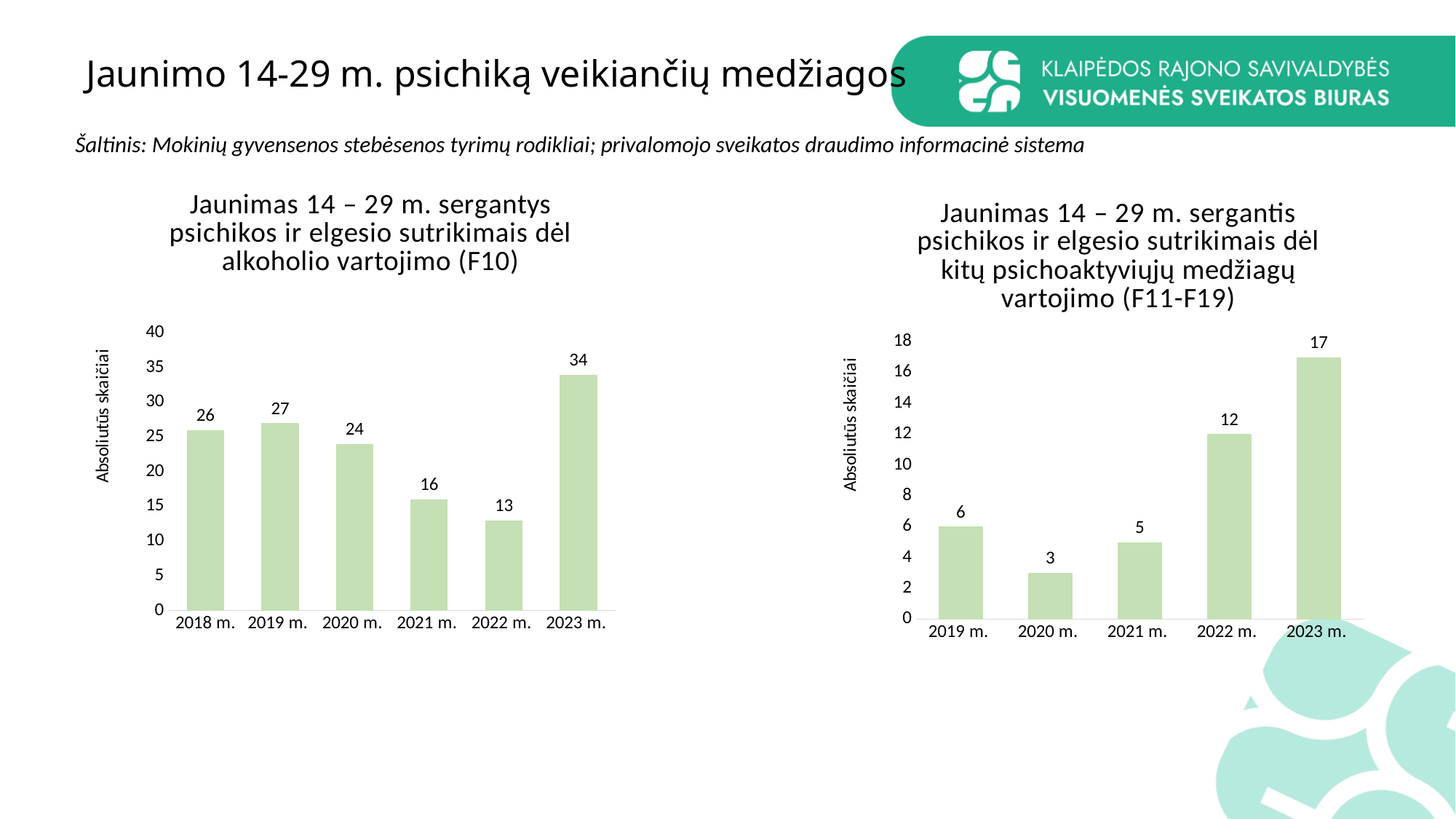
In the right chart (F11-F19), what is the difference between the values for 2023 m. and 2022 m.? 5 In the left chart (alkoholio vartojimo, F10), what is the value for 2023 m.? 34 In the right chart (F11-F19), which year has the highest value? 2023 m. In the left chart (alkoholio vartojimo, F10), how many years are shown on the x axis? 6 In the right chart (F11-F19), how many years are shown on the x axis? 5 In the left chart (alkoholio vartojimo, F10), do the values rise or fall from 2019 m. to 2022 m.? Fall What is the y-axis label of the left chart (alkoholio vartojimo, F10)? Absoliutūs skaičiai What kind of chart is the right chart (F11-F19)? Bar chart In the right chart (F11-F19), what is the value for 2020 m.? 3 In the left chart (alkoholio vartojimo, F10), is the value for 2019 m. larger than the value for 2020 m.? Yes In the left chart (alkoholio vartojimo, F10), what is the difference between the values for 2023 m. and 2022 m.? 21 In the left chart (alkoholio vartojimo, F10), which year has the lowest value? 2022 m.